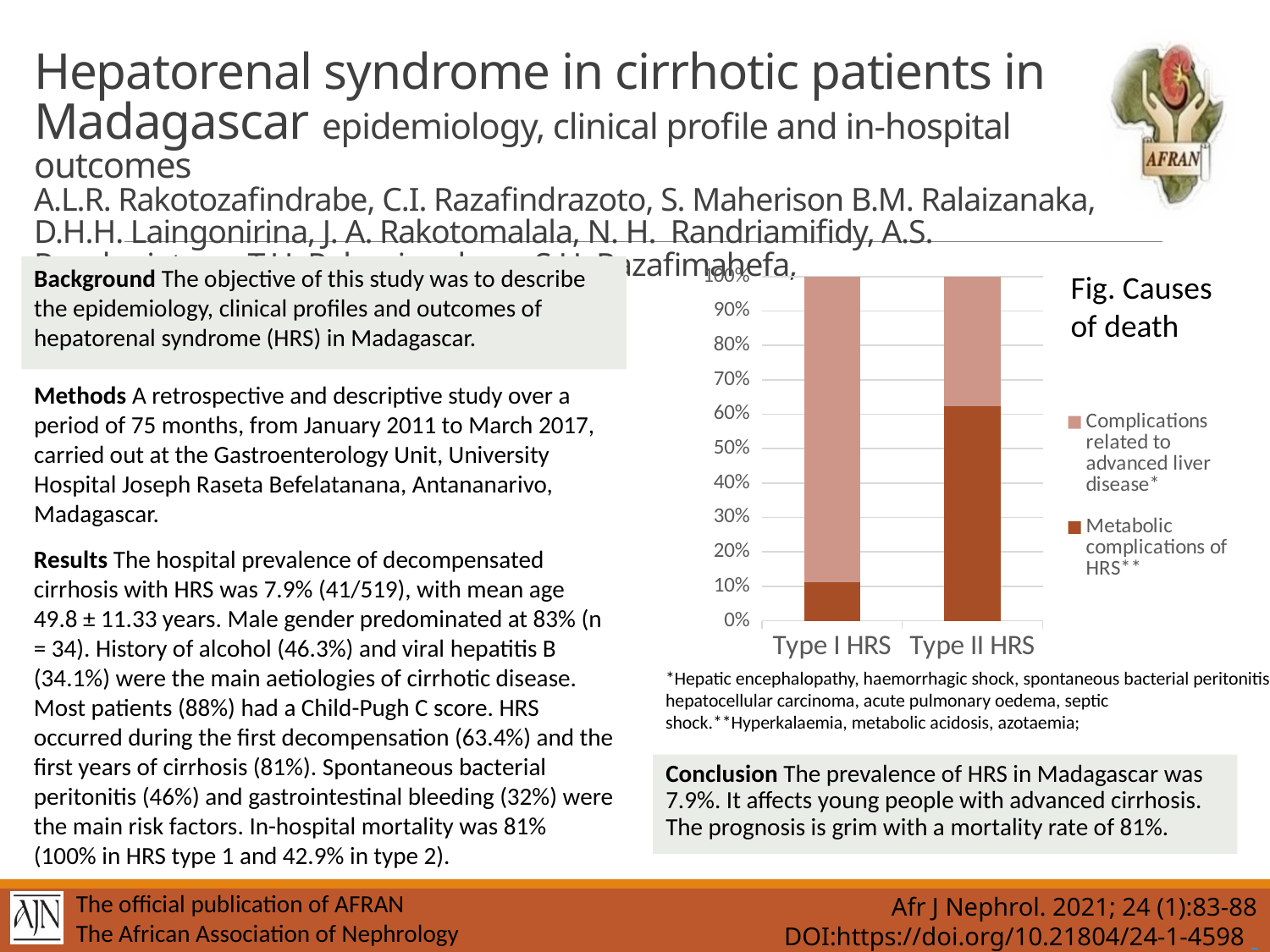
Which category has the larger share of Metabolic complications of HRS**, Type I HRS or Type II HRS? Type II HRS Is the share of Complications related to advanced liver disease* for Type I HRS greater or less than 80%? greater Is the share of Metabolic complications of HRS** for Type I HRS greater or less than 20%? less Is the share of Complications related to advanced liver disease* for Type II HRS greater or less than 50%? less How many categories are shown on the x axis of the chart? 2 How many series does the chart's legend list? 2 What is the title of the chart? Fig. Causes of death Which category has the larger share of Complications related to advanced liver disease*, Type I HRS or Type II HRS? Type I HRS Which series is shown in the darker brown colour at the bottom of each bar? Metabolic complications of HRS** What kind of chart is shown on the slide? stacked bar chart Which category has the highest share of Metabolic complications of HRS**? Type II HRS